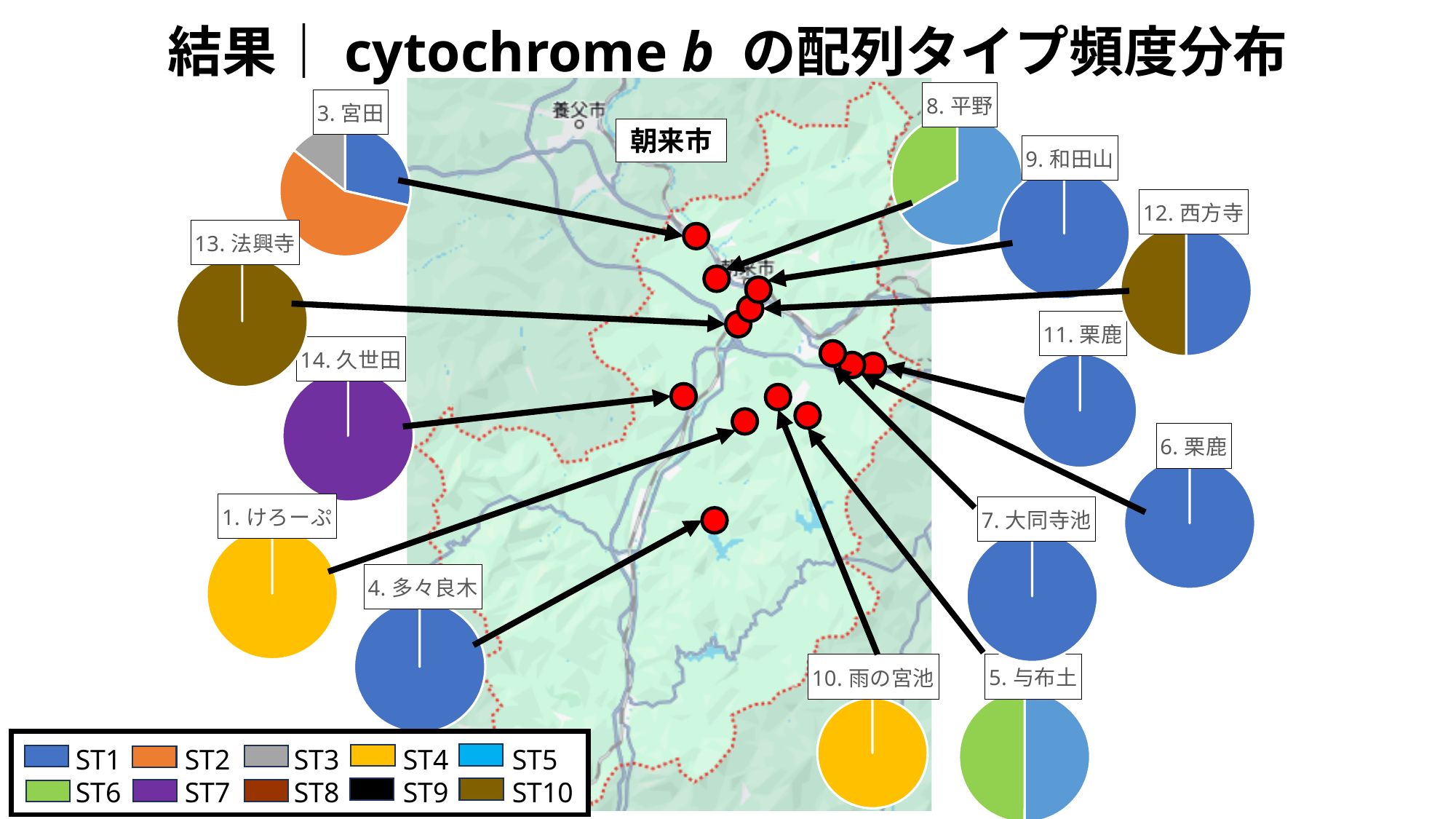
In the pie chart for 8. 平野, which slice is larger, ST5 or ST6? ST5 How many slices does the pie chart for 12. 西方寺 have? 2 Which sequence type makes up the entire pie chart for 14. 久世田? ST7 Which sequence type makes up the entire pie chart for 13. 法興寺? ST10 What kind of charts are placed around the map on this slide? pie charts How many sequence types (ST) does the legend list? 10 How many pie charts are shown on the slide? 13 In the pie chart for 3. 宮田, which sequence type has the largest slice? ST2 Which sequence type makes up the entire pie chart for 1. けろーぷ? ST4 In the pie chart for 3. 宮田, which slice is larger, ST1 or ST3? ST1 In the pie chart for 8. 平野, which sequence type has the largest slice? ST5 In the pie chart for 3. 宮田, which sequence type has the smallest slice? ST3